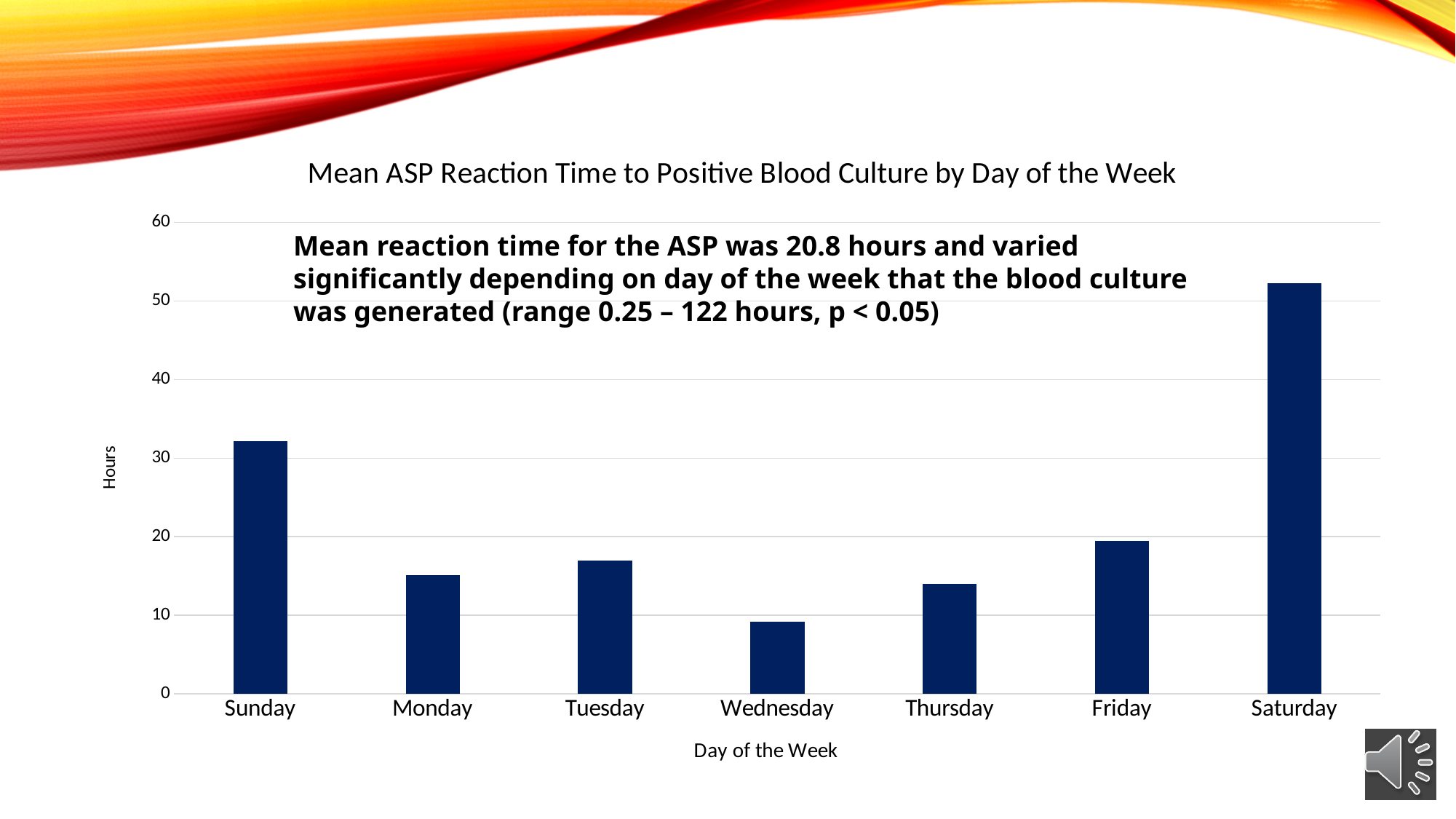
Is the value for Wednesday greater or less than 10? less Is the value for Saturday greater or less than 50? greater What kind of chart is shown on the slide? Bar chart Which has a higher mean reaction time, Thursday or Friday? Friday How many days of the week are plotted on the chart? 7 Is the value for Sunday greater or less than 30? greater Which day of the week has the lowest mean ASP reaction time? Wednesday Which has a higher mean reaction time, Sunday or Saturday? Saturday What is the title of the chart? Mean ASP Reaction Time to Positive Blood Culture by Day of the Week What is the label on the vertical axis of the chart? Hours Which day of the week has the highest mean ASP reaction time? Saturday